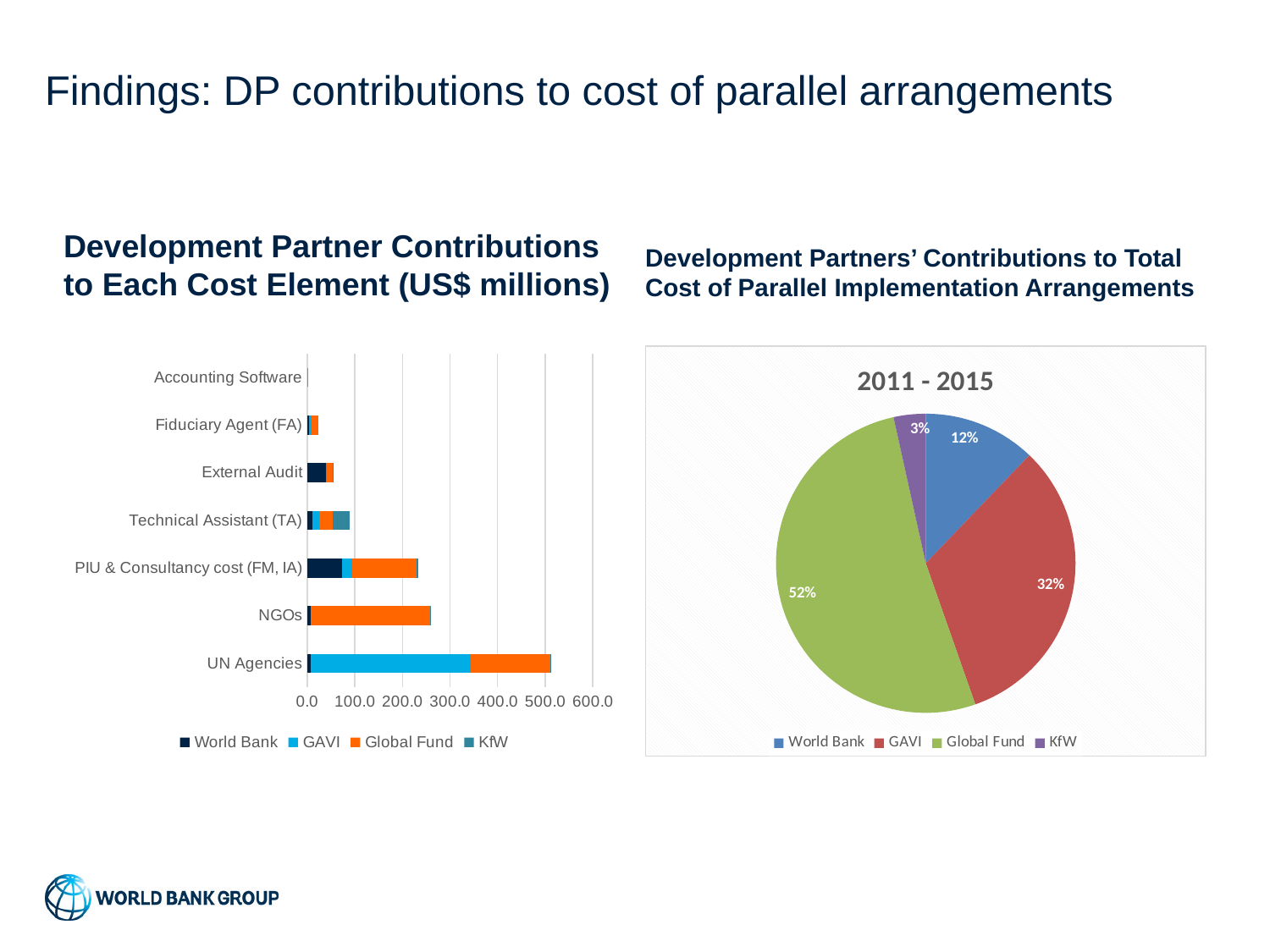
In the pie chart on the right, what percentage is shown for World Bank? 12% How many series does the legend of the bar chart on the left list? 4 In the pie chart on the right, how many percentage points larger is the Global Fund share than the GAVI share? 20 percentage points What type of chart is the 'Development Partner Contributions to Each Cost Element' chart on the left? Stacked bar chart In the pie chart on the right, what share of the total cost is contributed by Global Fund? 52% In the bar chart on the left, which cost element has the longest total bar? UN Agencies In the pie chart on the right, what percentage is shown for KfW? 3% In the pie chart on the right, which development partner has the largest share? Global Fund In the pie chart on the right, which development partner has the smallest share? KfW In the bar chart on the left, is the total value for UN Agencies greater or less than 400.0? greater In the pie chart on the right, what percentage is shown for GAVI? 32% How many cost element categories are shown in the bar chart on the left? 7